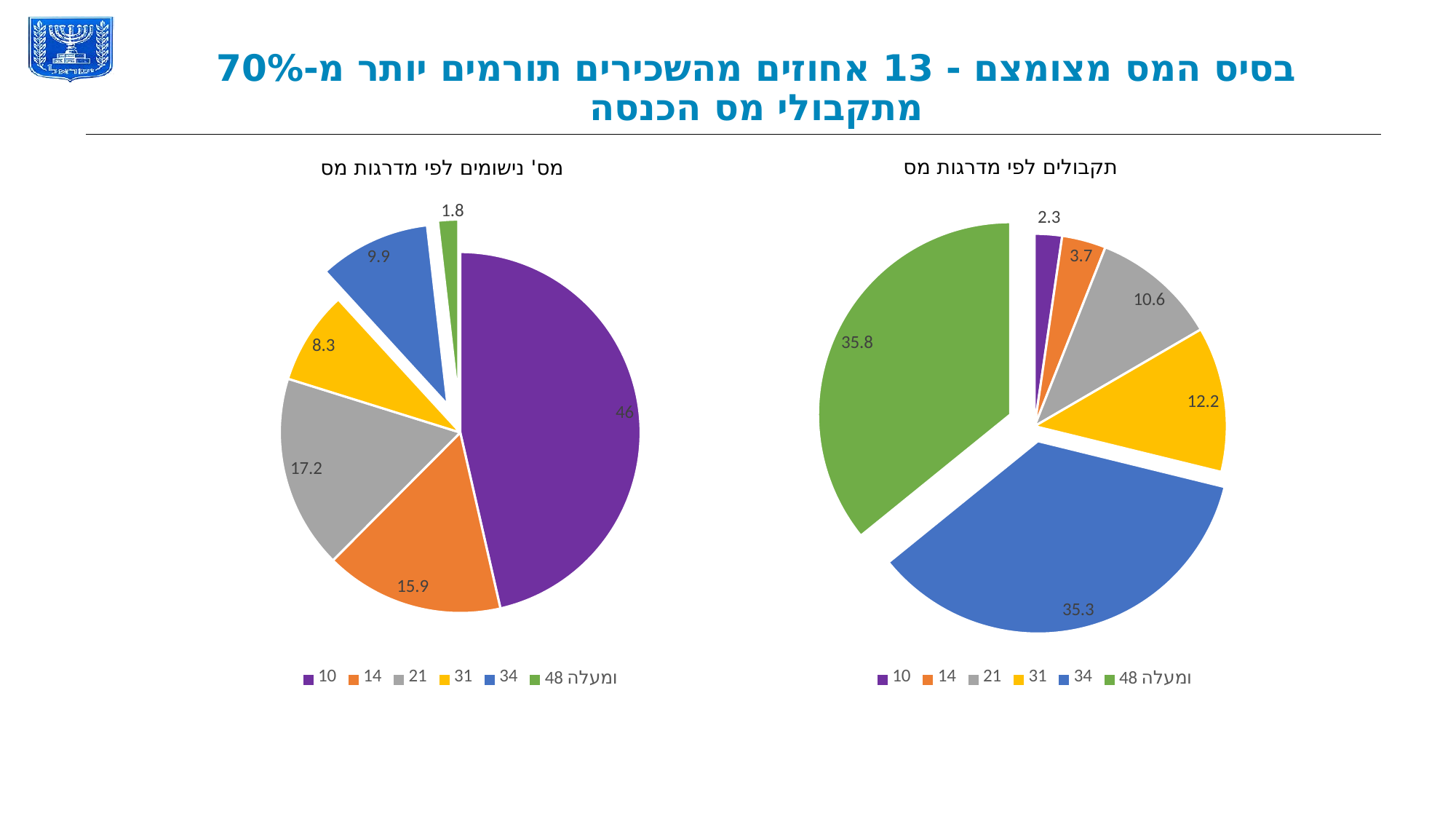
In the left pie chart (מס' נישומים לפי מדרגות מס), what is the difference between the values for the 21 bracket and the 14 bracket? 1.3 How many slices does the right pie chart (תקבולים לפי מדרגות מס) have? 6 In the left pie chart (מס' נישומים לפי מדרגות מס), which is larger: the value for the 34 bracket or the 31 bracket? 34 In the right pie chart (תקבולים לפי מדרגות מס), what is the value for the 34 bracket? 35.3 In the left pie chart (מס' נישומים לפי מדרגות מס), which bracket has the smallest slice? 48 ומעלה In the left pie chart (מס' נישומים לפי מדרגות מס), what colour is the slice for the 31 bracket? Yellow In the left pie chart (מס' נישומים לפי מדרגות מס), what is the value for the 10 bracket? 46 In the right pie chart (תקבולים לפי מדרגות מס), what is the difference between the values for the 31 bracket and the 21 bracket? 1.6 In the right pie chart (תקבולים לפי מדרגות מס), what is the value for the 48 ומעלה bracket? 35.8 What type of chart is used on the left side of the slide? Pie chart In the right pie chart (תקבולים לפי מדרגות מס), which bracket has the smallest slice? 10 In the left pie chart (מס' נישומים לפי מדרגות מס), which bracket has the largest slice? 10